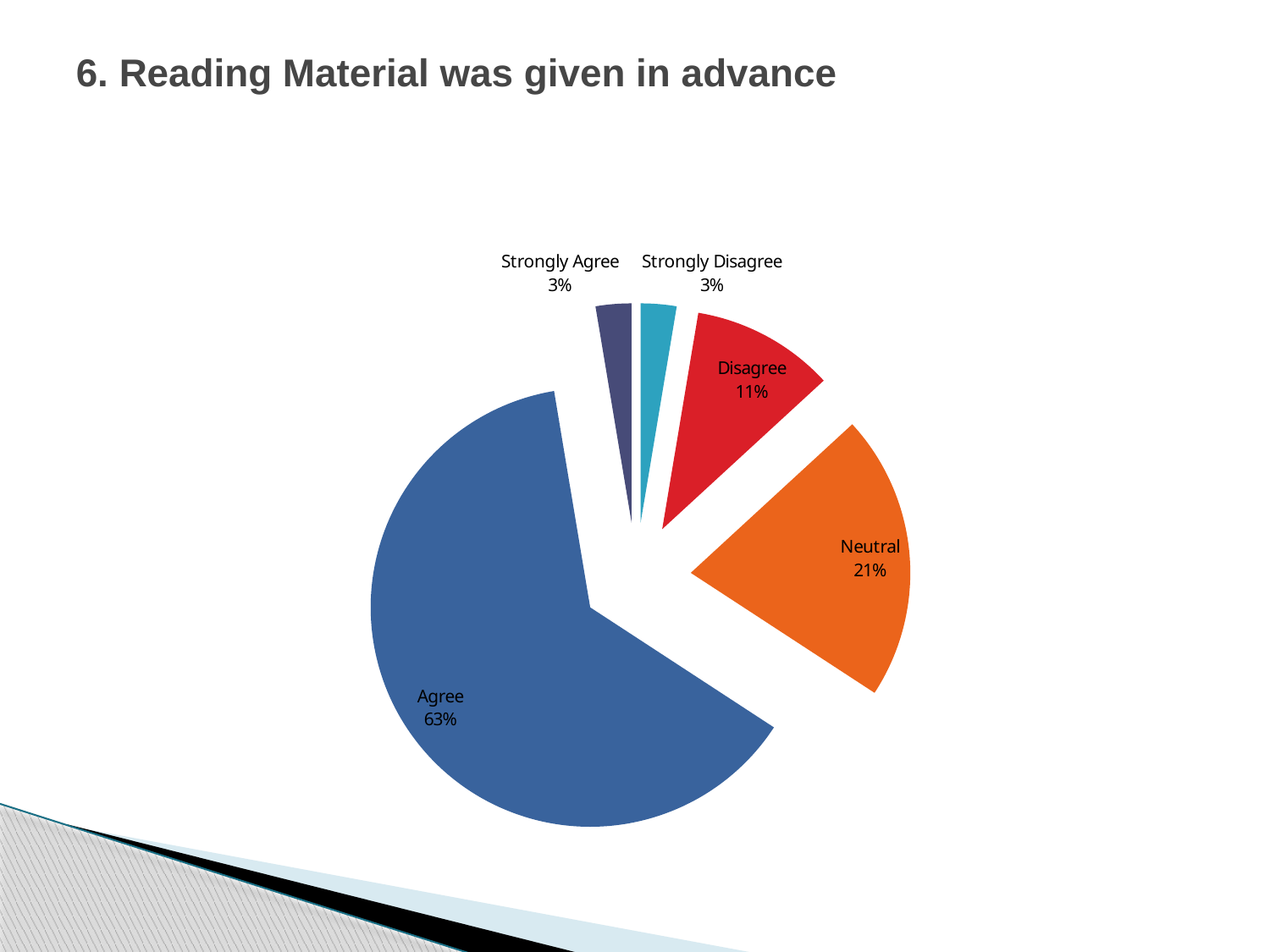
What is the combined share of Agree and Strongly Agree? 66% What is the difference in percentage points between Agree and Neutral? 42 What type of chart is shown on the slide? pie chart What is the title of the slide containing the chart? 6. Reading Material was given in advance Which response category has the largest share of the pie? Agree What percentage of respondents chose Agree? 63% What colour is the Neutral slice? orange How many slices does the pie chart have? 5 What percentage of respondents chose Strongly Agree? 3% What percentage of respondents chose Disagree? 11% Which is larger, the Neutral share or the Disagree share? Neutral What percentage of respondents chose Neutral? 21%